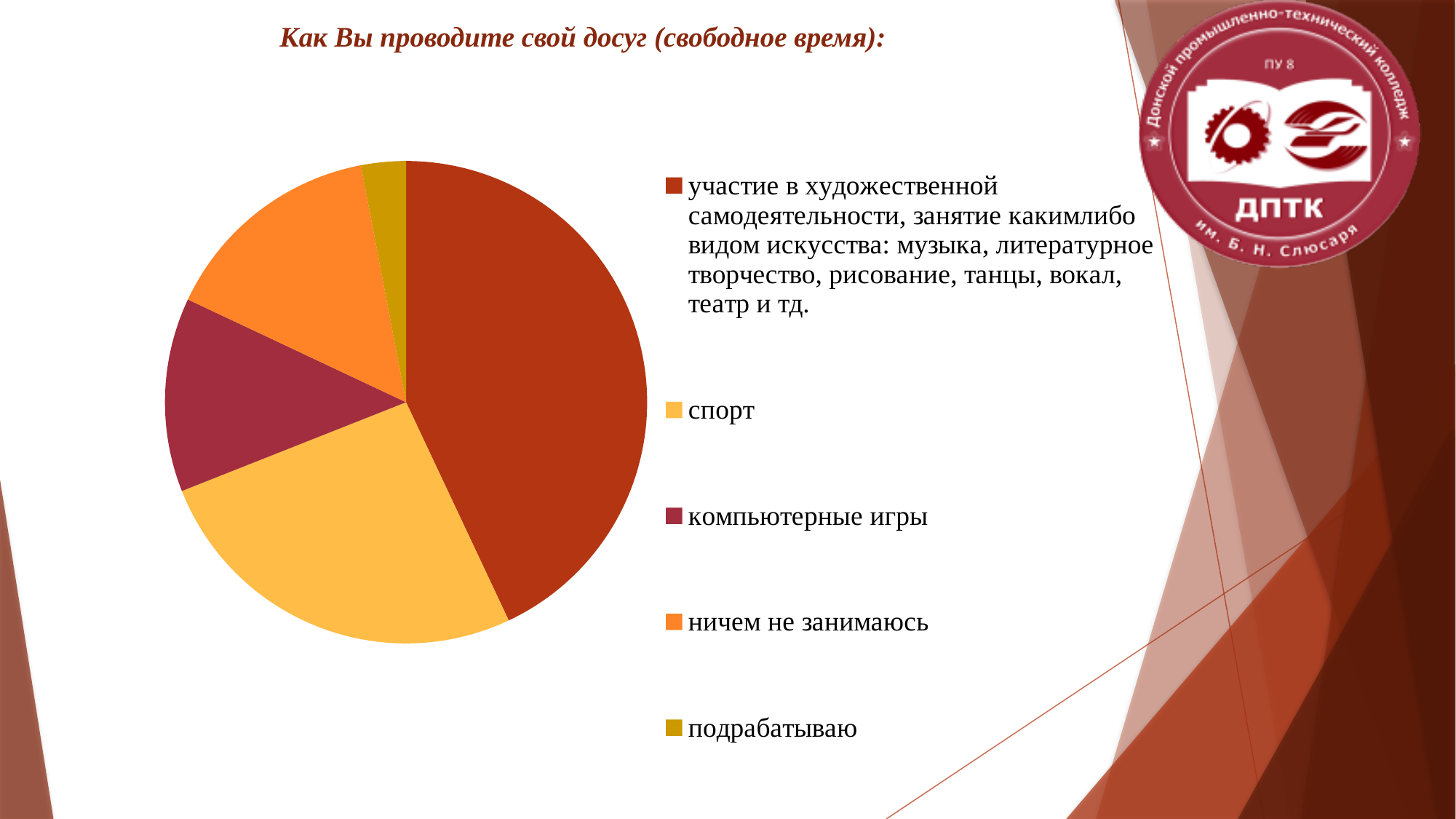
What kind of chart is shown on the slide? pie chart How many slices does the pie chart have? 5 Which slice is larger: участие в художественной самодеятельности or спорт? участие в художественной самодеятельности Which legend entry is shown in yellow? спорт Which slice is larger: ничем не занимаюсь or подрабатываю? ничем не занимаюсь Which slice is larger: спорт or компьютерные игры? спорт Which category has the smallest slice of the pie chart? подрабатываю Which category has the largest slice of the pie chart? участие в художественной самодеятельности, занятие какимлибо видом искусства: музыка, литературное творчество, рисование, танцы, вокал, театр и тд. What is the title of the slide above the pie chart? Как Вы проводите свой досуг (свободное время): How many entries does the legend of the pie chart list? 5